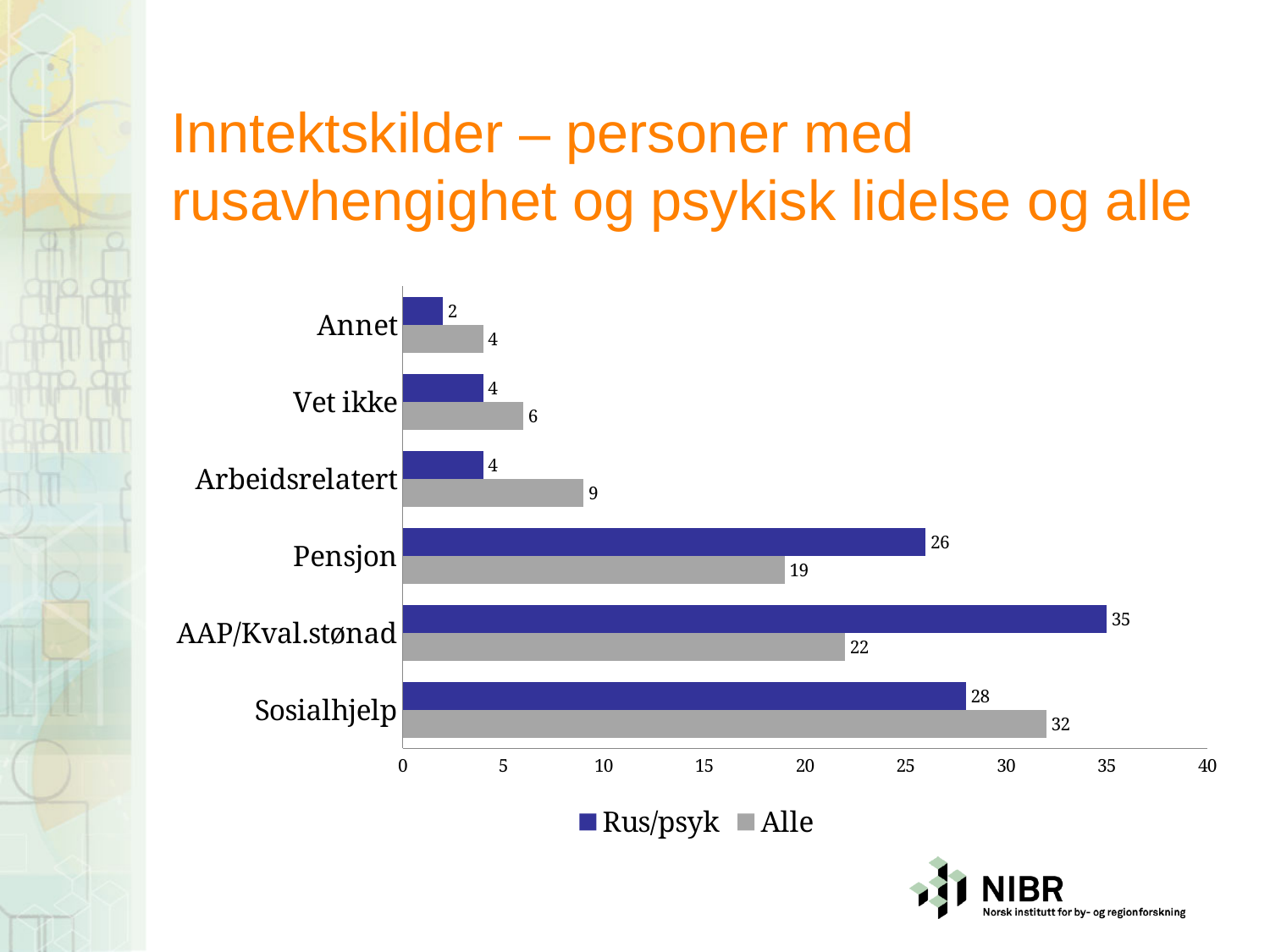
Which category has the lowest Rus/psyk value? Annet How many categories are shown on the chart? 6 Is the Rus/psyk value for Pensjon greater or less than 20? greater What is the Rus/psyk value for AAP/Kval.stønad? 35 Which series is shown in grey? Alle What is the difference between the Rus/psyk and Alle values for AAP/Kval.stønad? 13 Which category has the highest Rus/psyk value? AAP/Kval.stønad What is the Alle value for Sosialhjelp? 32 What is the Alle value for Arbeidsrelatert? 9 What kind of chart is shown on the slide? Bar chart How many series does the legend list? 2 For Sosialhjelp, which series has the larger value, Rus/psyk or Alle? Alle